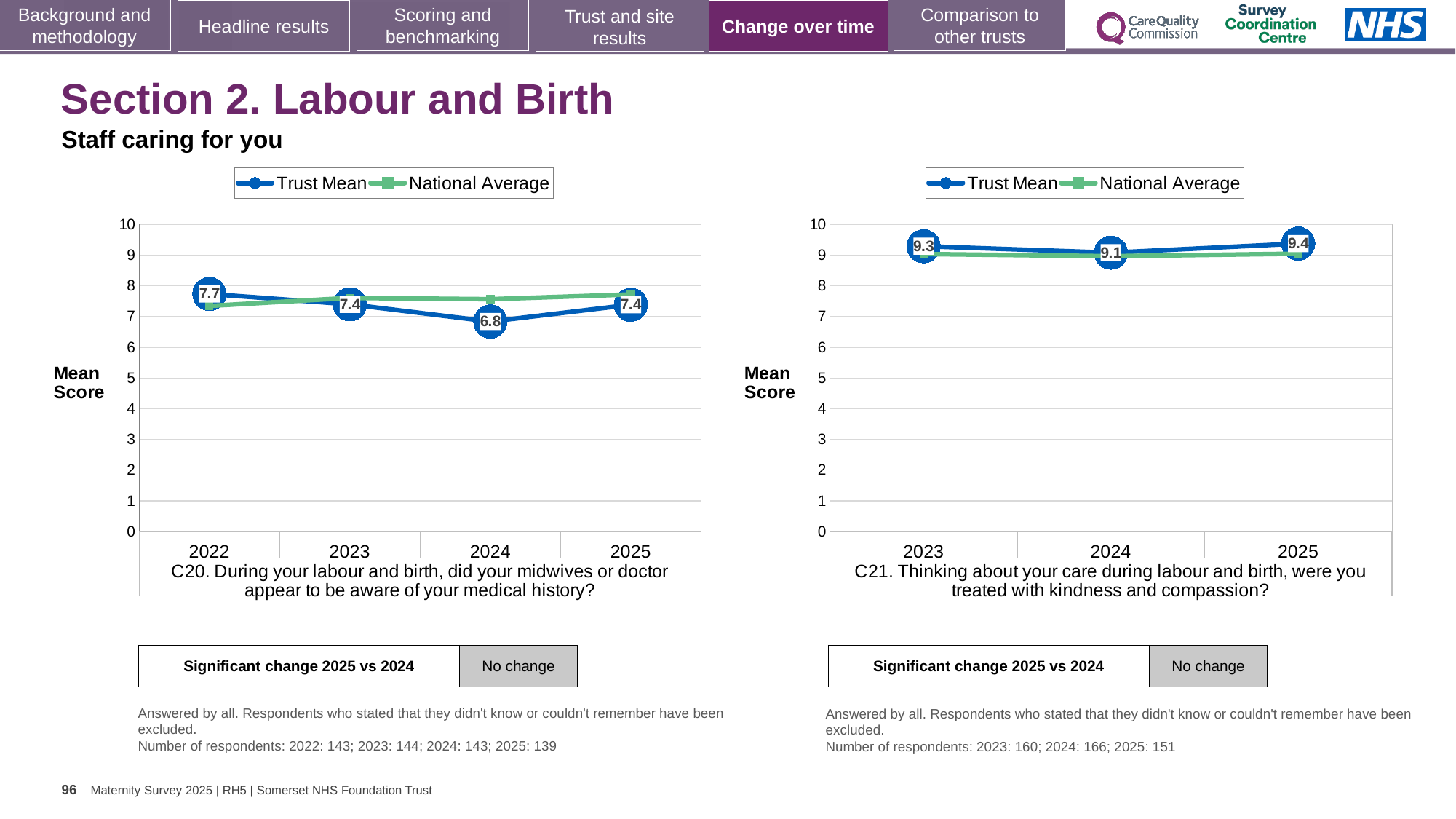
How many series does the legend of the right chart (C21) list? 2 In the left chart (C20), which year has the lowest Trust Mean score? 2024 In the right chart (C21), is the Trust Mean score for 2023 larger or smaller than the score for 2024? larger In the right chart (C21), what is the difference between the Trust Mean scores for 2025 and 2024? 0.3 In the left chart (C20), what is the Trust Mean score for 2022? 7.7 In the left chart (C20), is the National Average value for 2025 greater or less than 7? greater In the left chart (C20), what is the difference between the Trust Mean scores for 2022 and 2024? 0.9 In the right chart (C21), what is the Trust Mean score for 2025? 9.4 In the left chart (C20), what is the Trust Mean score for 2024? 6.8 In the right chart (C21), which year has the highest Trust Mean score? 2025 What type of chart is the left chart (C20)? line chart How many years are plotted on the x axis of the left chart (C20)? 4